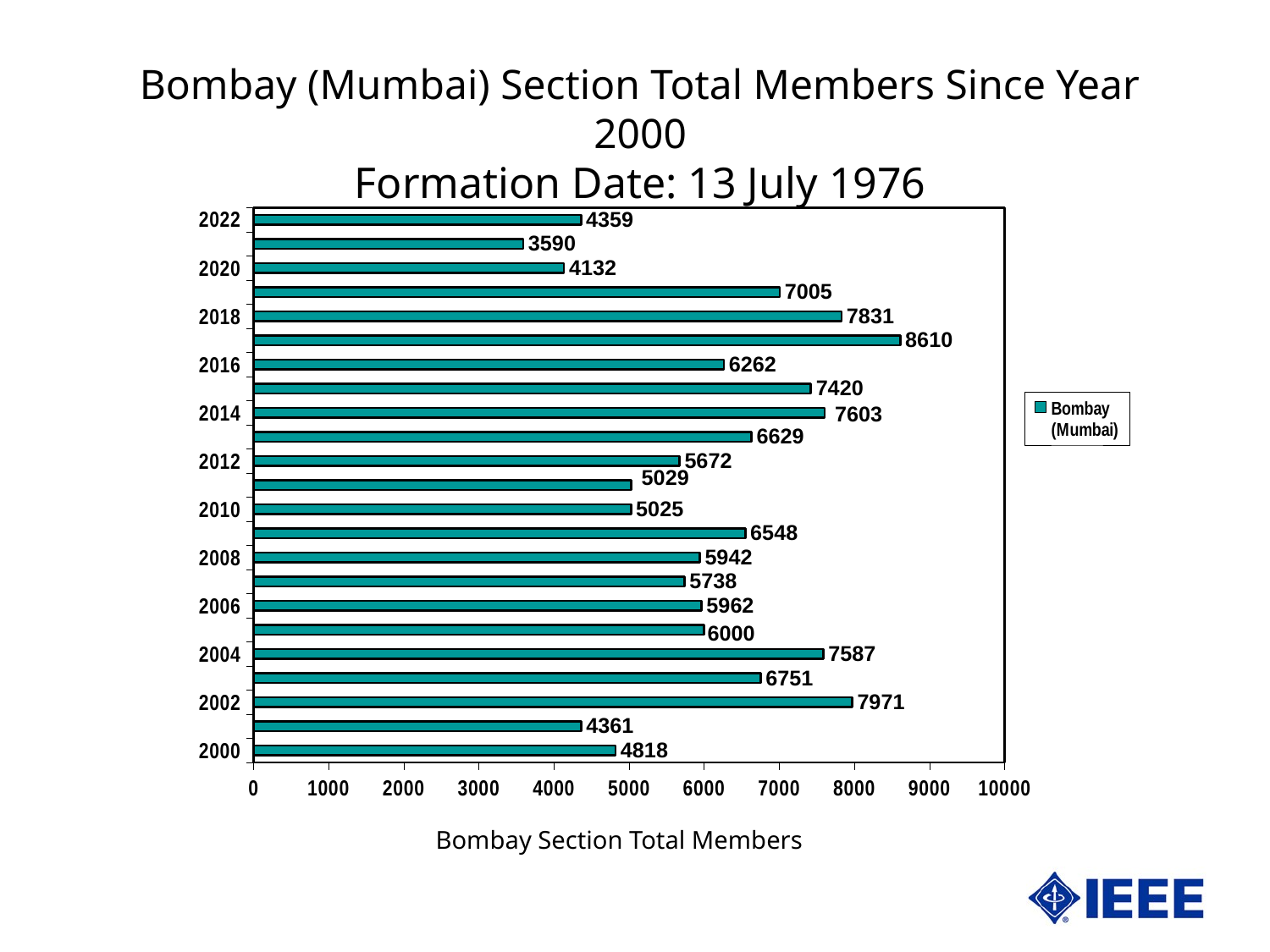
What was the Bombay (Mumbai) Section total membership in 2010? 5025 What is the lowest membership value shown on the chart? 3590 What type of chart is shown on the slide? bar chart What was the Bombay (Mumbai) Section total membership in 2000? 4818 How many bars (years) are plotted on the chart? 23 Which year had more members, 2014 or 2016? 2014 What was the Bombay (Mumbai) Section total membership in 2022? 4359 What is the highest membership value shown on the chart? 8610 Is the membership value for 2020 greater or less than 5000? less What is the difference between the membership in 2002 and in 2000? 3153 What was the Bombay (Mumbai) Section total membership in 2018? 7831 How many series does the legend list? 1